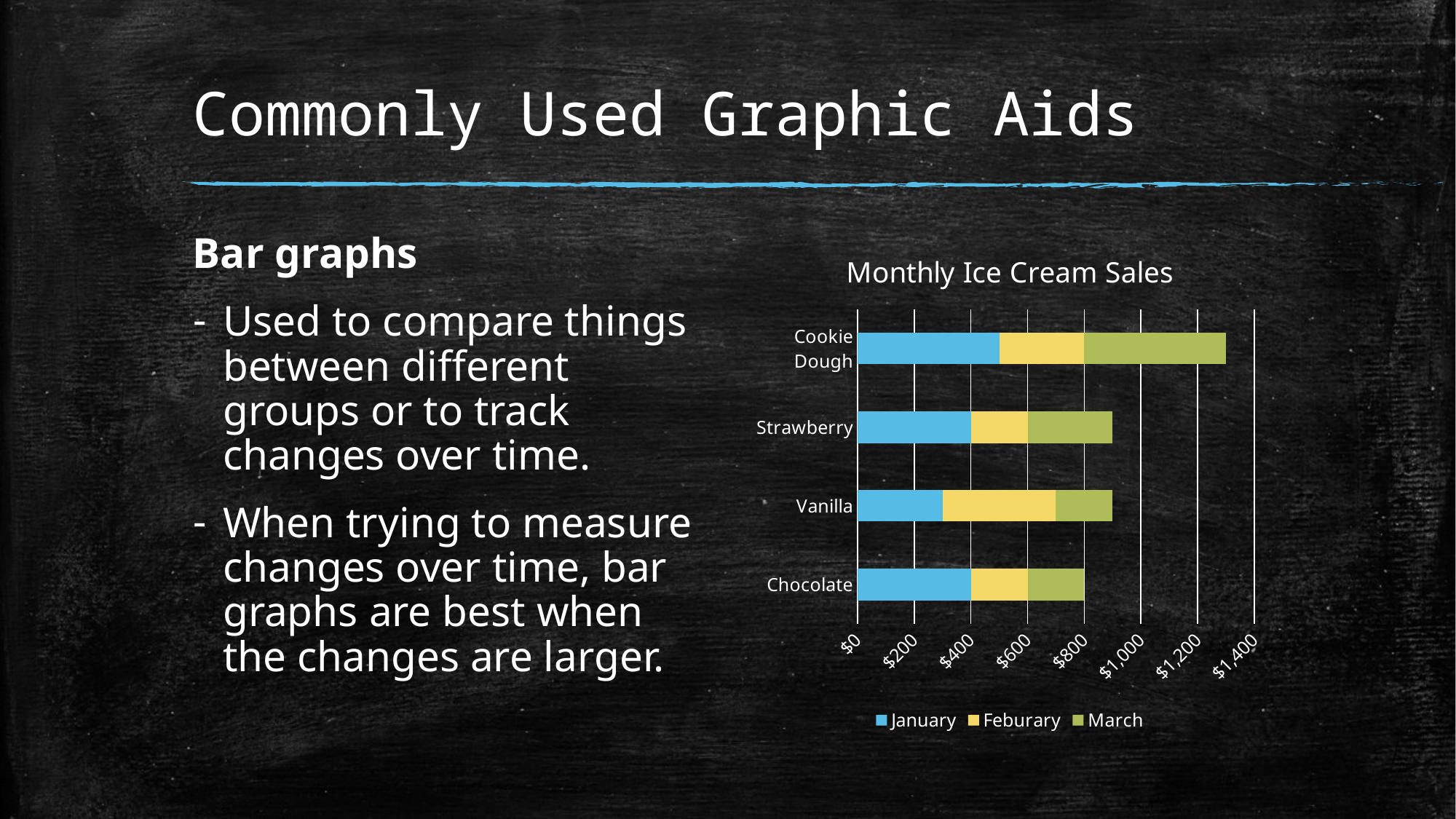
How many ice cream flavors are shown on the chart? 4 Is the total bar for Cookie Dough greater or less than $1,200? greater Is the total bar for Vanilla greater or less than $600? greater Is the total bar for Chocolate greater or less than $1,000? less Which has the larger total sales, Cookie Dough or Chocolate? Cookie Dough Which flavor has the highest total sales across the three months? Cookie Dough Which months are listed in the chart's legend? January, Feburary, March What is the title of the chart? Monthly Ice Cream Sales Which flavor has the lowest total sales across the three months? Chocolate What kind of chart is shown on the slide? Bar chart How many series does the chart's legend list? 3